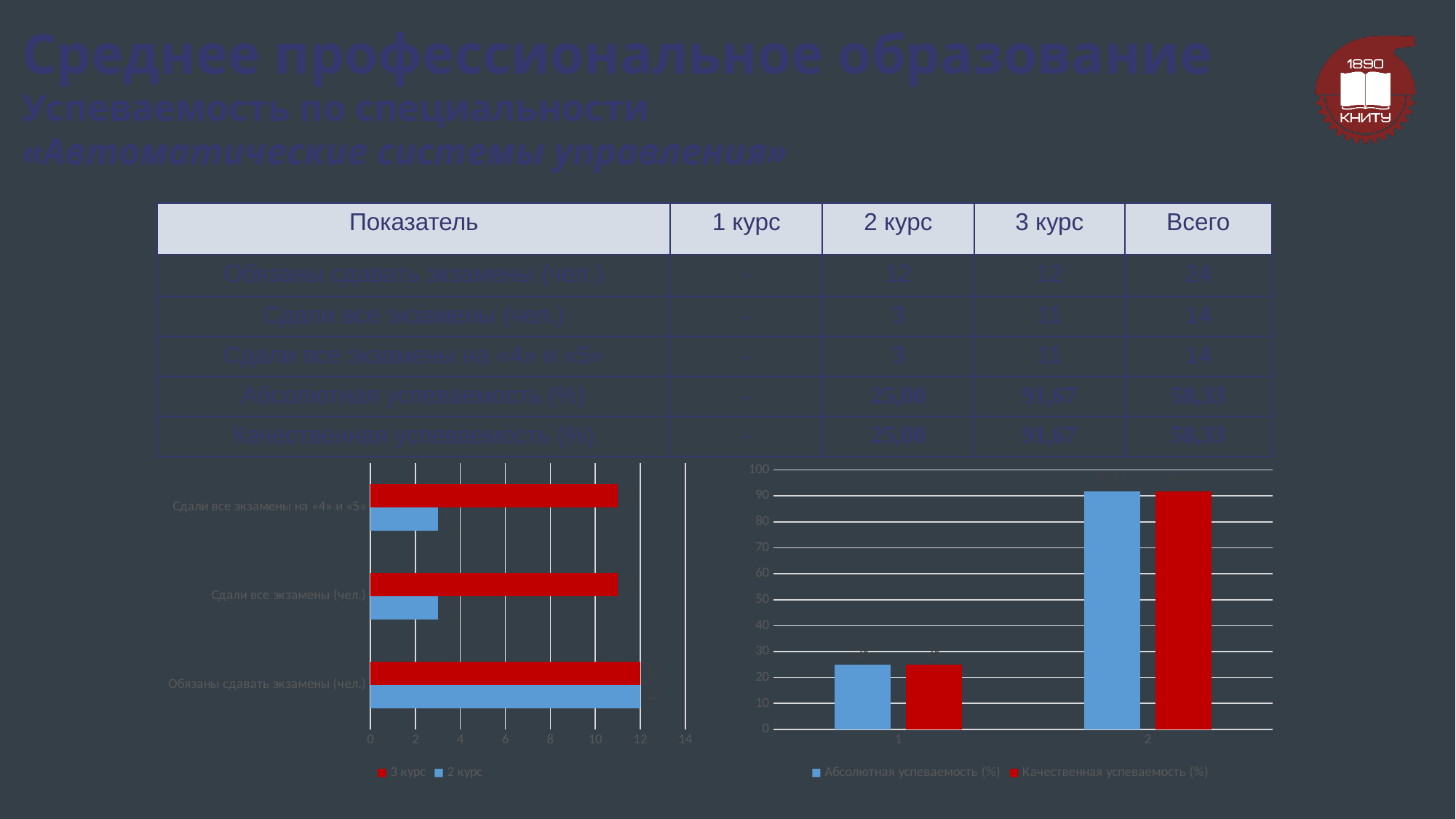
What kind of chart is the chart on the left of the slide? bar chart How many series does the legend of the left chart list? 2 In the left chart, is the 2 курс value for Сдали все экзамены (чел.) greater or less than 4? less In the right chart, is the Качественная успеваемость (%) value for category 2 greater or less than 80? greater How many categories are shown on the x axis of the right chart? 2 What kind of chart is the chart on the right of the slide? bar chart In the right chart, is the Абсолютная успеваемость (%) value for category 1 greater or less than 30? less How many series does the legend of the right chart list? 2 In the left chart, what is the value of the 2 курс bar for Обязаны сдавать экзамены (чел.)? 12 How many categories are shown on the left chart? 3 In the left chart, which series has the larger value for Сдали все экзамены (чел.), 3 курс or 2 курс? 3 курс